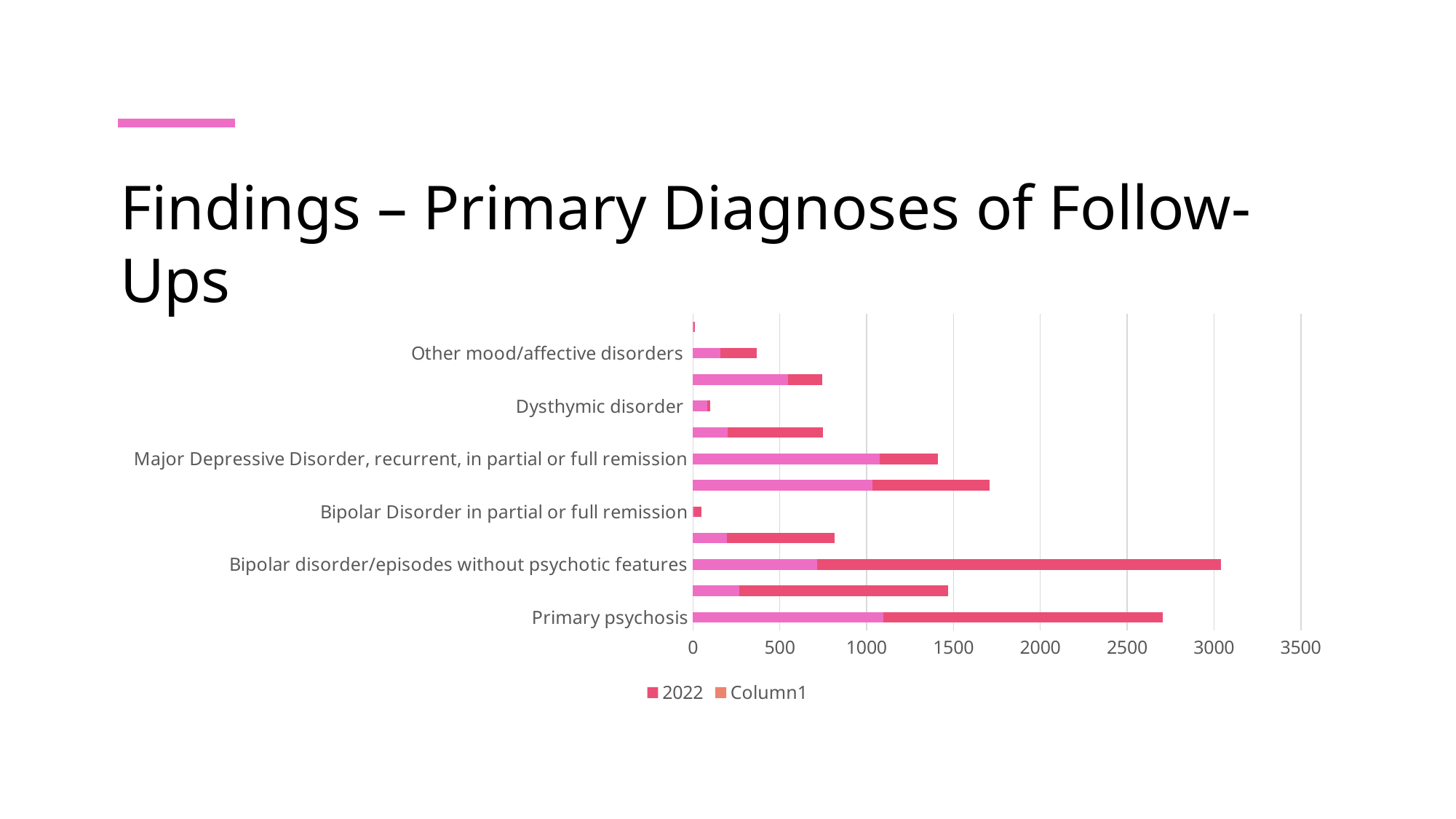
What are the two series names shown in the chart legend? 2022 and Column1 Which has a longer bar: Other mood/affective disorders or Bipolar Disorder in partial or full remission? Other mood/affective disorders Is the total bar length for Other mood/affective disorders greater or less than 500? less Which has a longer bar: Primary psychosis or Major Depressive Disorder, recurrent, in partial or full remission? Primary psychosis Is the total bar length for Primary psychosis greater or less than 2500? greater How many series does the chart legend list? 2 What kind of chart is shown on the slide? bar chart Is the total bar length for Bipolar disorder/episodes without psychotic features greater or less than 2500? greater Which labeled category has the longest bar in the chart? Bipolar disorder/episodes without psychotic features What is the title of the slide containing the chart? Findings – Primary Diagnoses of Follow-Ups